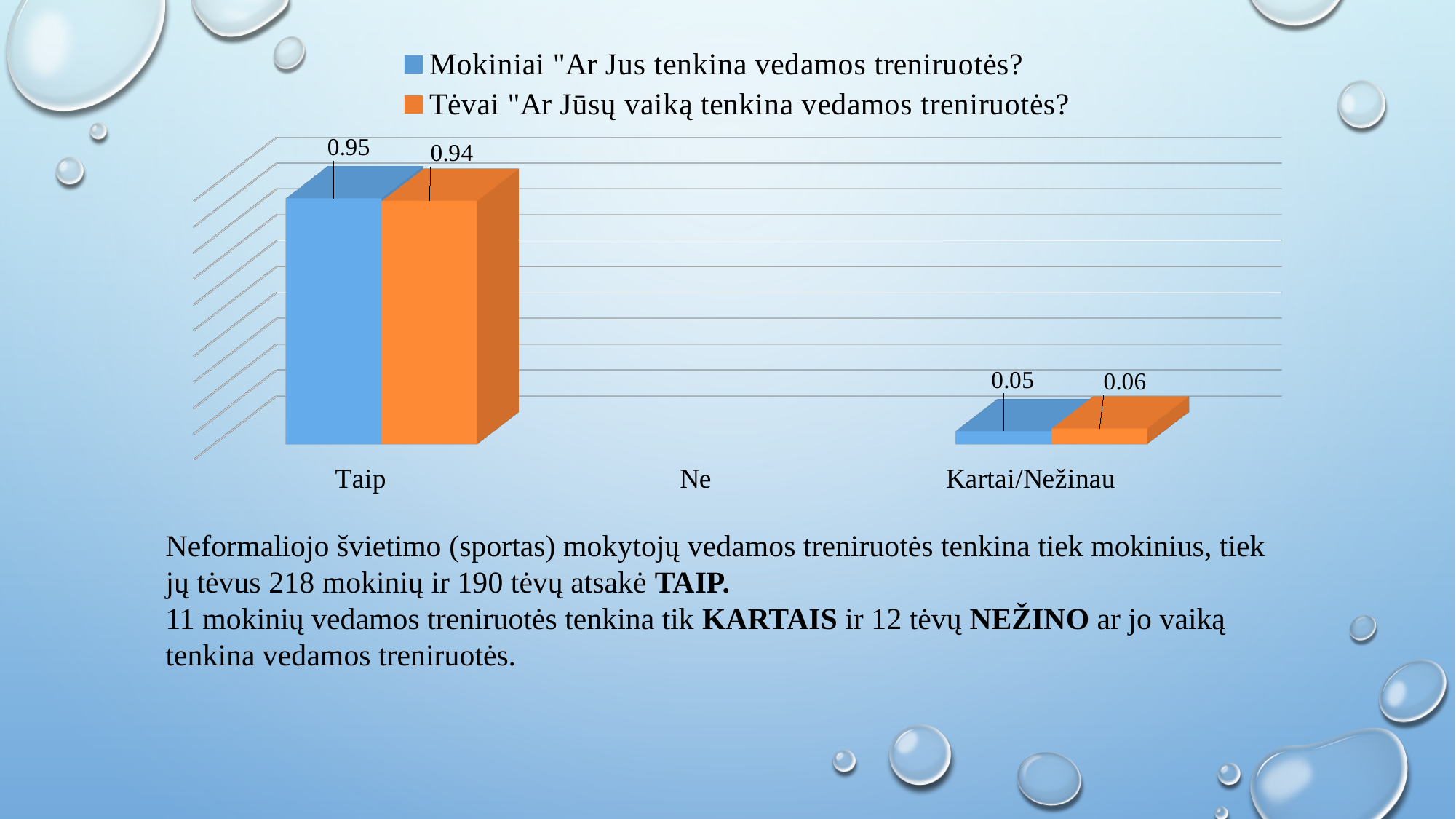
What is the value for Tėvai in the Taip category? 0.94 What is the difference between the Tėvai value for Taip and the Tėvai value for Kartai/Nežinau? 0.88 What is the value for Mokiniai in the Taip category? 0.95 What is the value for Mokiniai in the Kartai/Nežinau category? 0.05 How many categories are shown on the x axis? 3 Which category has the highest value for the Mokiniai series? Taip Which colour represents the Tėvai series in the chart? Orange What is the value for Tėvai in the Kartai/Nežinau category? 0.06 Which is larger: the Mokiniai value for Taip or the Mokiniai value for Kartai/Nežinau? Taip What kind of chart is shown on the slide? Bar chart What is the difference between the Mokiniai and Tėvai values in the Taip category? 0.01 How many series does the legend list? 2